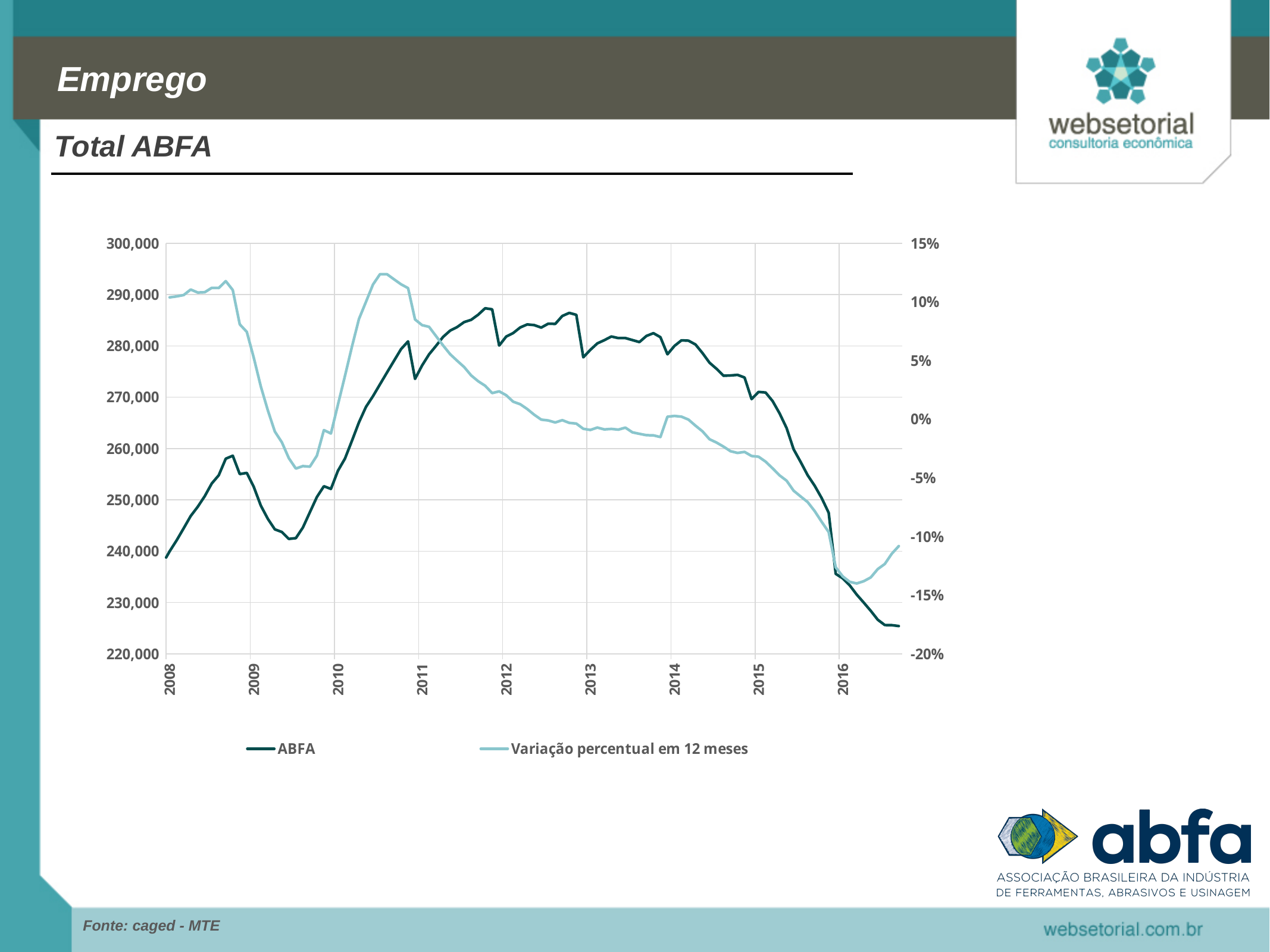
What kind of chart is shown on the slide? line chart How many year labels are shown on the x axis? 9 Does the ABFA line rise or fall between 2015 and 2016? fall Does the ABFA line rise or fall between mid-2009 and 2011? rise What is the title shown above the chart? Total ABFA Is the ABFA value at the end of the series (late 2016) greater or less than 230,000? less Is the peak of the Variação percentual em 12 meses line in 2010 greater or less than 10%? greater Is the ABFA value at the start of 2008 greater or less than 250,000? less How many series does the legend list? 2 What are the two series named in the legend? ABFA; Variação percentual em 12 meses